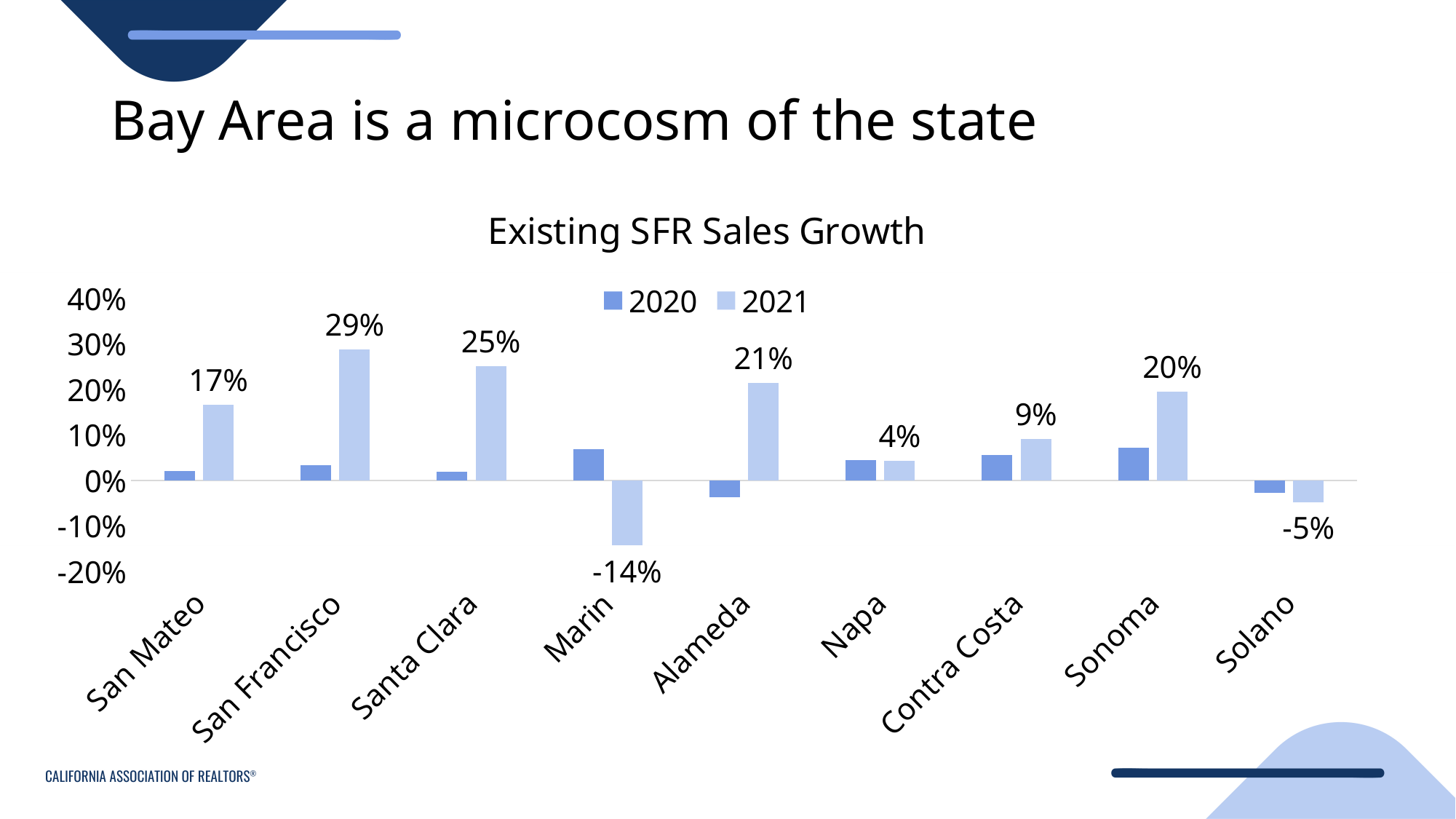
Which is larger, the 2021 value for Alameda or the 2021 value for Sonoma? Alameda What is the difference between the 2021 values for San Francisco and Santa Clara? 4% How many series does the legend list? 2 What is the 2021 value for Marin? -14% Which county has the highest 2021 value? San Francisco What is the 2021 value for San Francisco? 29% Is the 2020 value for Marin greater or less than 0%? greater Which county has the lowest 2021 value? Marin What kind of chart is shown? bar chart What is the title of the chart? Existing SFR Sales Growth How many counties are shown on the x axis? 9 What is the 2021 value for Napa? 4%